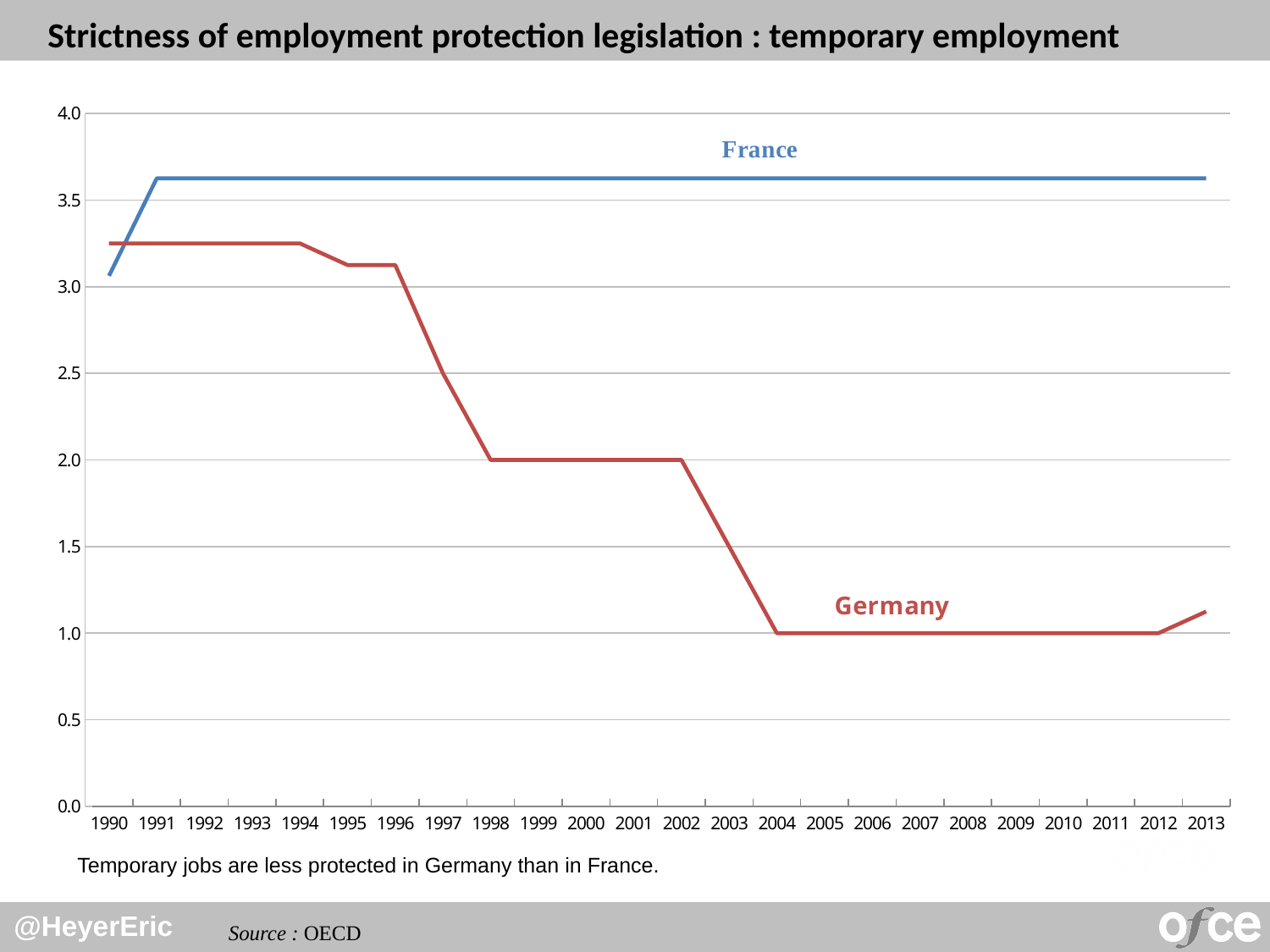
Is the value for France in 1990 greater or less than 3.5? less Which country has the higher value in 2010? France What kind of chart is shown on the slide? line chart Is the value for Germany in 1996 greater or less than 3.0? greater What is the value for Germany in 2000? 2.0 Is the value for France in 2005 greater or less than 3.5? greater What is the value for Germany in 2008? 1.0 How many years are shown on the x axis? 24 What is the title of the chart? Strictness of employment protection legislation : temporary employment Does the Germany line generally rise or fall from 1994 to 2004? fall How many series are plotted on the chart? 2 Which two countries are plotted on the chart? France and Germany